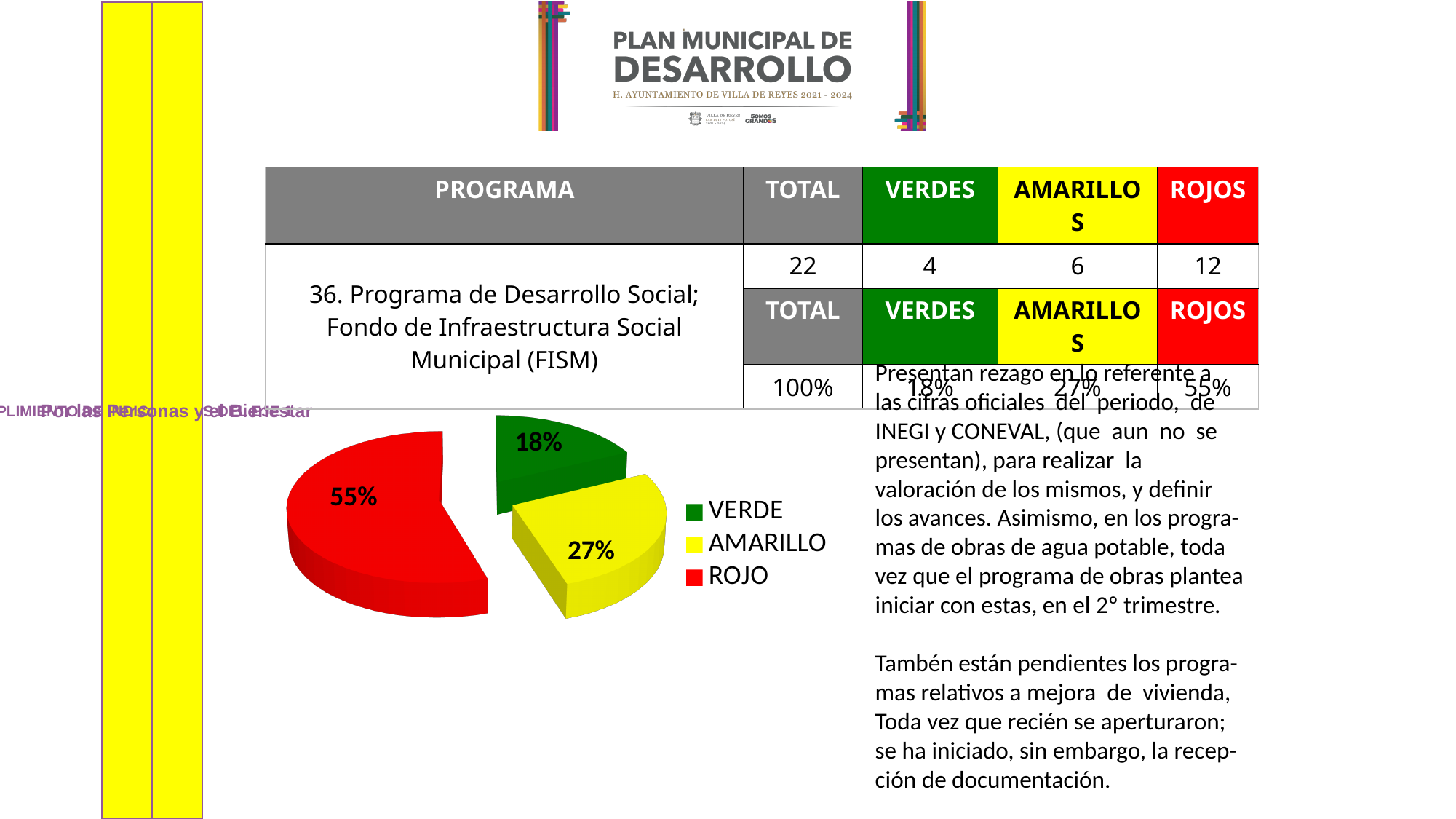
Which slice of the pie chart is the smallest? VERDE Which is larger in the pie chart, the AMARILLO slice or the VERDE slice? AMARILLO What is the difference in percentage points between the AMARILLO and VERDE slices? 9 What kind of chart is shown on the slide? pie chart What is the difference in percentage points between the ROJO and AMARILLO slices? 28 Which slice of the pie chart is the largest? ROJO What percentage does the VERDE slice show in the pie chart? 18% What percentage does the ROJO slice show in the pie chart? 55% What percentage does the AMARILLO slice show in the pie chart? 27% How many slices does the pie chart have? 3 What colour is the ROJO slice in the pie chart? red How many entries does the pie chart legend list? 3